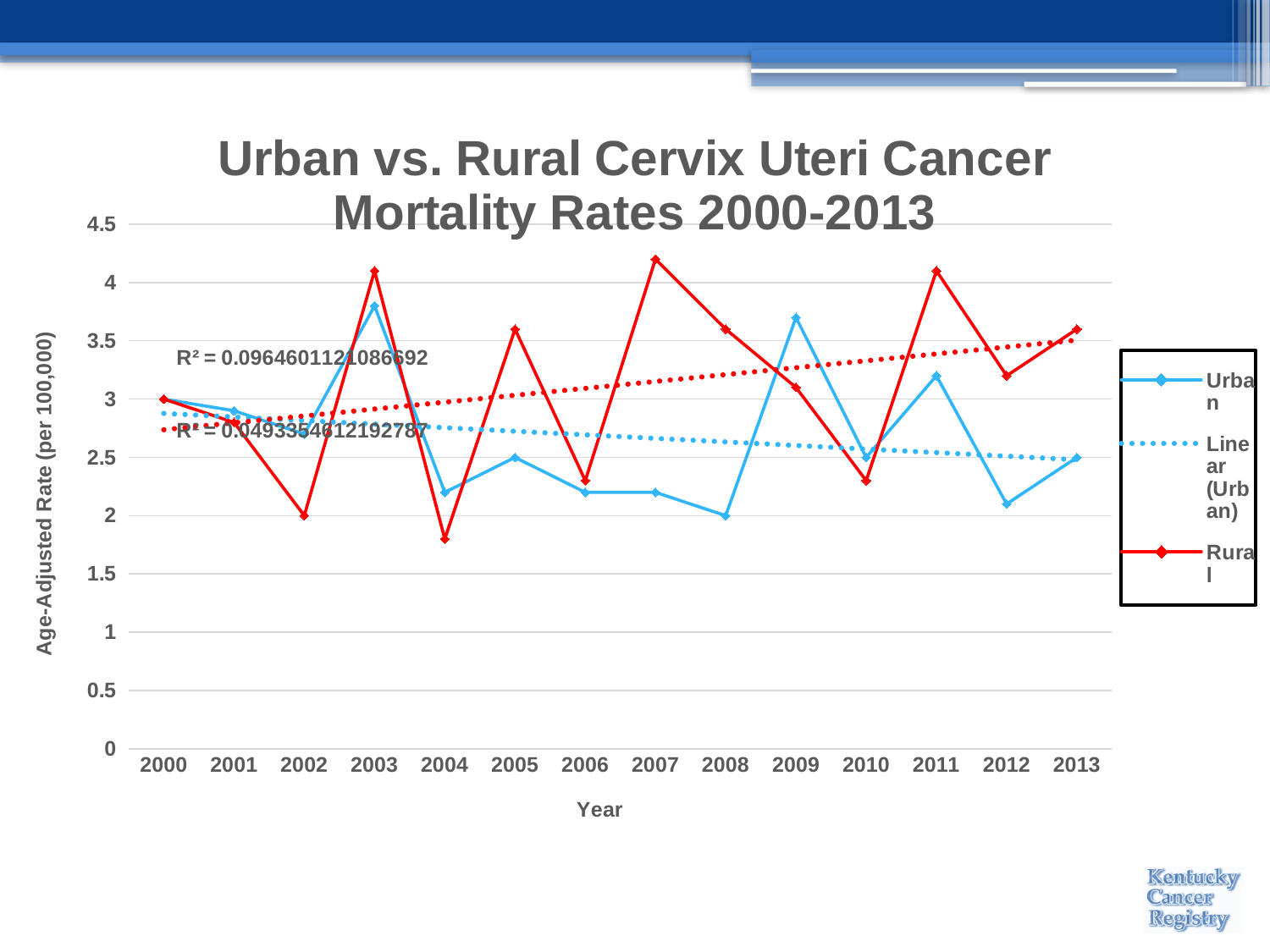
Is the Urban value for 2012 greater or less than 2.5? less What kind of chart is shown on the slide? line chart How many entries does the chart legend list? 3 In which year is the Rural value lowest? 2004 In 2009, which series has the higher value, Urban or Rural? Urban In 2007, which series has the higher value, Urban or Rural? Rural What is the title of the chart? Urban vs. Rural Cervix Uteri Cancer Mortality Rates 2000-2013 Is the Rural value for 2004 greater or less than 2? less What is the label on the y axis of the chart? Age-Adjusted Rate (per 100,000) How many years are shown on the x axis of the chart? 14 Is the Rural value for 2007 greater or less than 4? greater